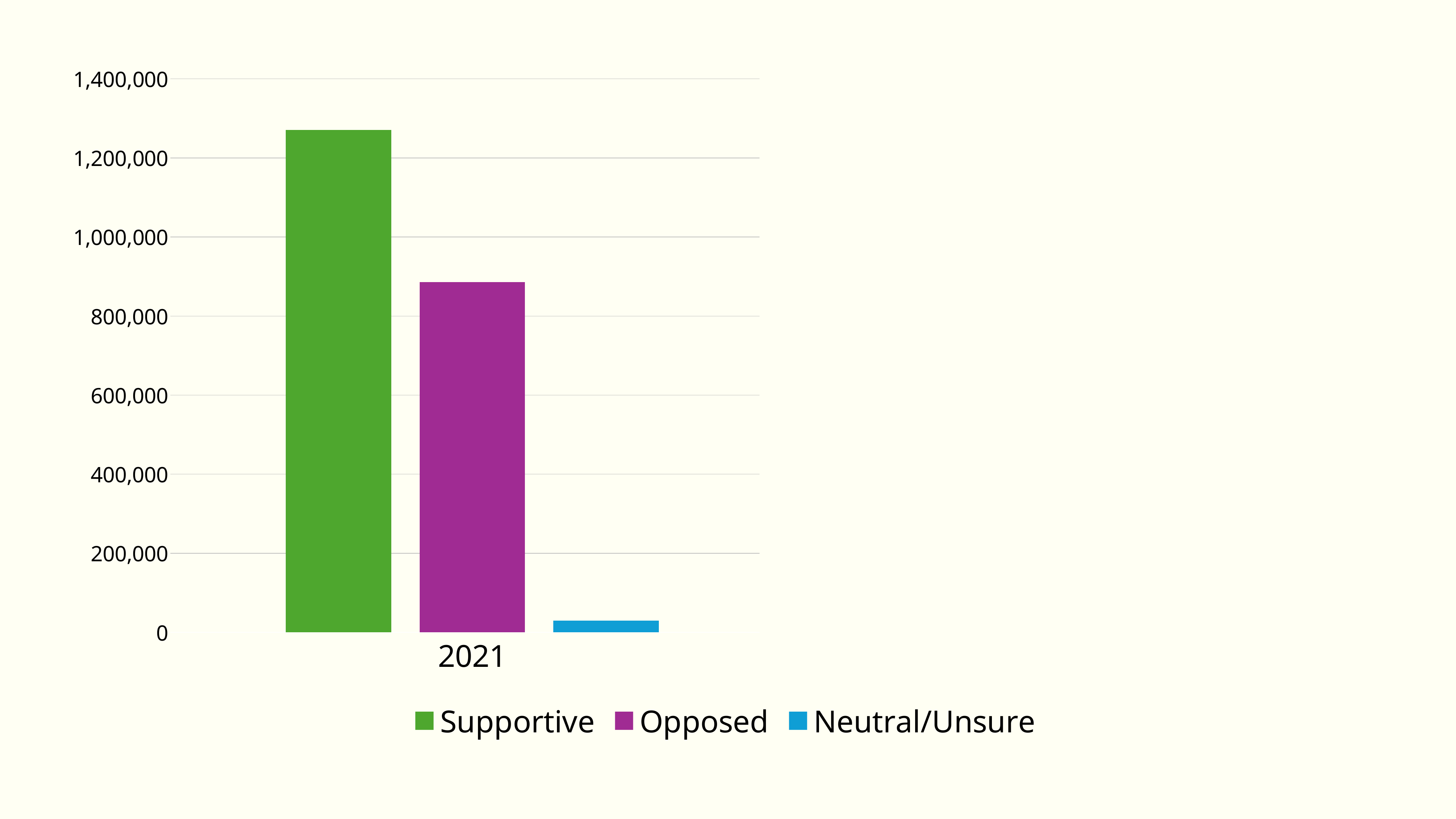
How many series does the legend list? 3 How many categories are shown on the x axis? 1 What kind of chart is shown on the slide? bar chart Which series has the lowest value for 2021? Neutral/Unsure What colour is the bar for the Opposed series? purple Which series has the highest value for 2021? Supportive Which is larger for 2021, Supportive or Opposed? Supportive What is the category label shown on the x axis? 2021 Which is larger for 2021, Opposed or Neutral/Unsure? Opposed Is the value for Neutral/Unsure in 2021 greater or less than 200,000? less Is the value for Opposed in 2021 greater or less than 1,000,000? less Is the value for Supportive in 2021 greater or less than 1,200,000? greater